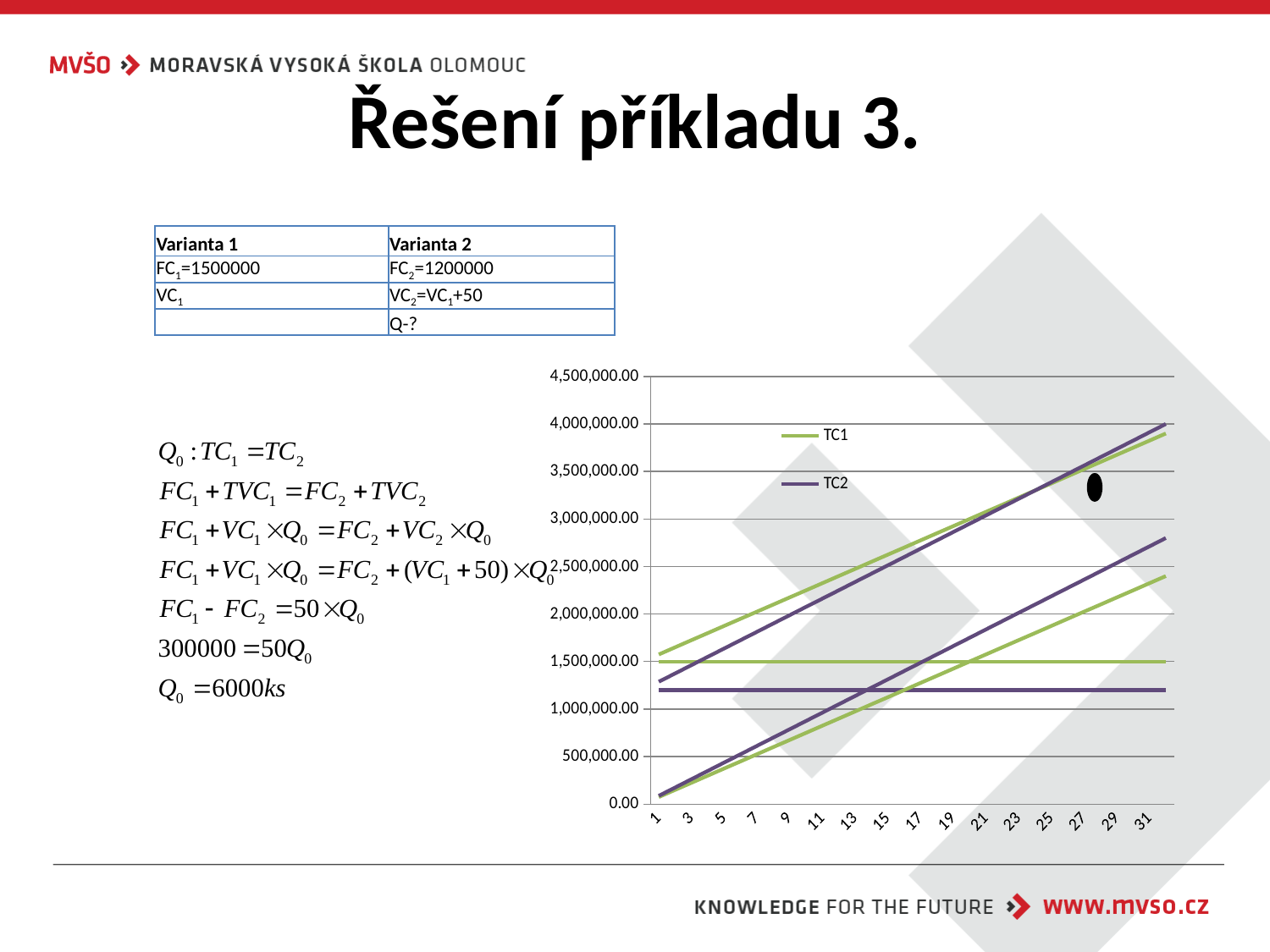
Is the value of TC2 at x = 31 greater or less than 3,500,000.00? greater At x = 1, which series has the larger value, TC1 or TC2? TC1 What kind of chart is shown on the slide? line chart Is the value of TC1 at x = 1 greater or less than 1,500,000.00? greater Is the value of TC2 at x = 1 greater or less than 1,500,000.00? less At x = 31, which series has the larger value, TC1 or TC2? TC2 What colour is the TC1 line in the chart? green How many series does the chart legend list? 2 Does the TC2 line rise or fall along the x axis? rise What are the two series named in the chart legend? TC1 and TC2 Does the TC1 line rise or fall as the x axis goes from 1 to 31? rise